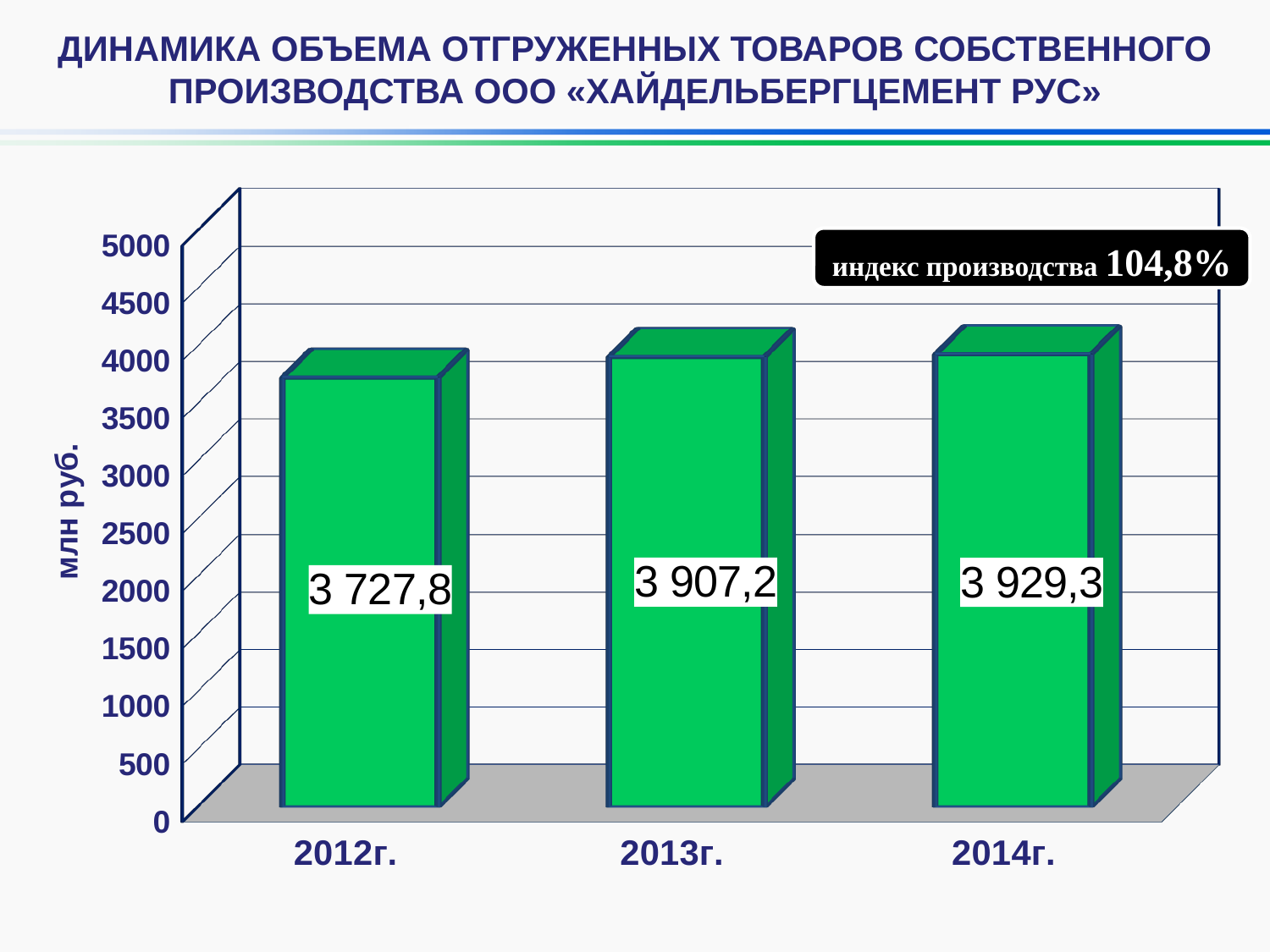
Which year has the highest value? 2014г. Which is larger, the value for 2012г. or the value for 2013г.? 2013г. What is the value for 2013г.? 3 907,2 What is the value for 2014г.? 3 929,3 What kind of chart is shown on the slide? bar chart What production index (индекс производства) is shown on the chart? 104,8% Is the value for 2012г. greater or less than 4000? less What is the value for 2012г.? 3 727,8 Which year has the lowest value? 2012г. How many years are shown on the chart? 3 What is the difference between the values for 2013г. and 2012г.? 179,4 What is the difference between the values for 2014г. and 2013г.? 22,1